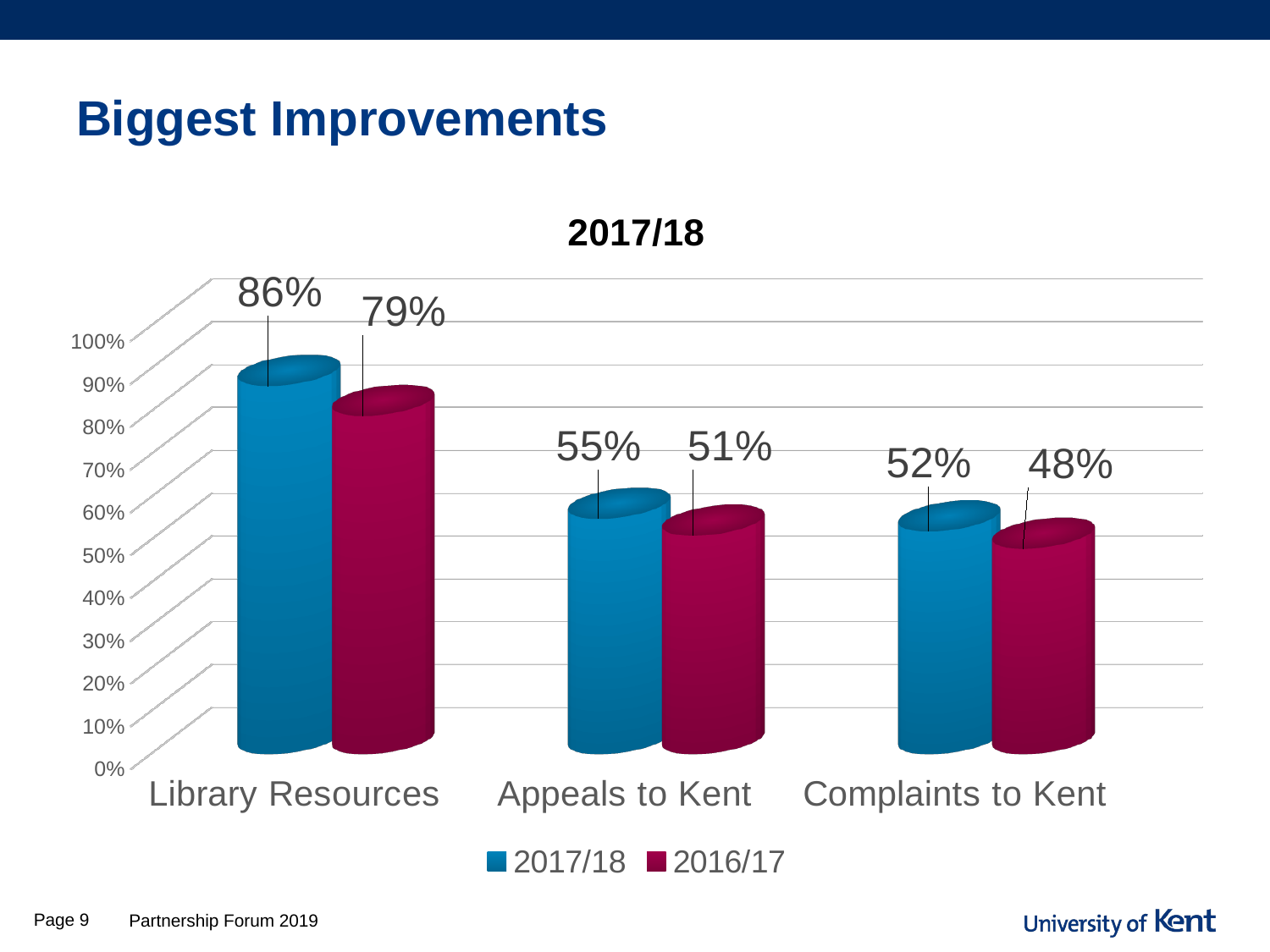
How many series does the legend list? 2 What kind of chart is shown on the slide? Bar chart Which category has the lowest 2016/17 value? Complaints to Kent What is the difference between the 2017/18 and 2016/17 values for Library Resources? 7% What is the difference between the 2017/18 and 2016/17 values for Appeals to Kent? 4% What is the 2017/18 value for Complaints to Kent? 52% How many categories are shown on the x axis? 3 Which category has the highest 2017/18 value? Library Resources Which is larger for Complaints to Kent, the 2017/18 value or the 2016/17 value? 2017/18 What is the 2016/17 value for Appeals to Kent? 51% What is the 2017/18 value for Library Resources? 86% What is the title of the chart? 2017/18